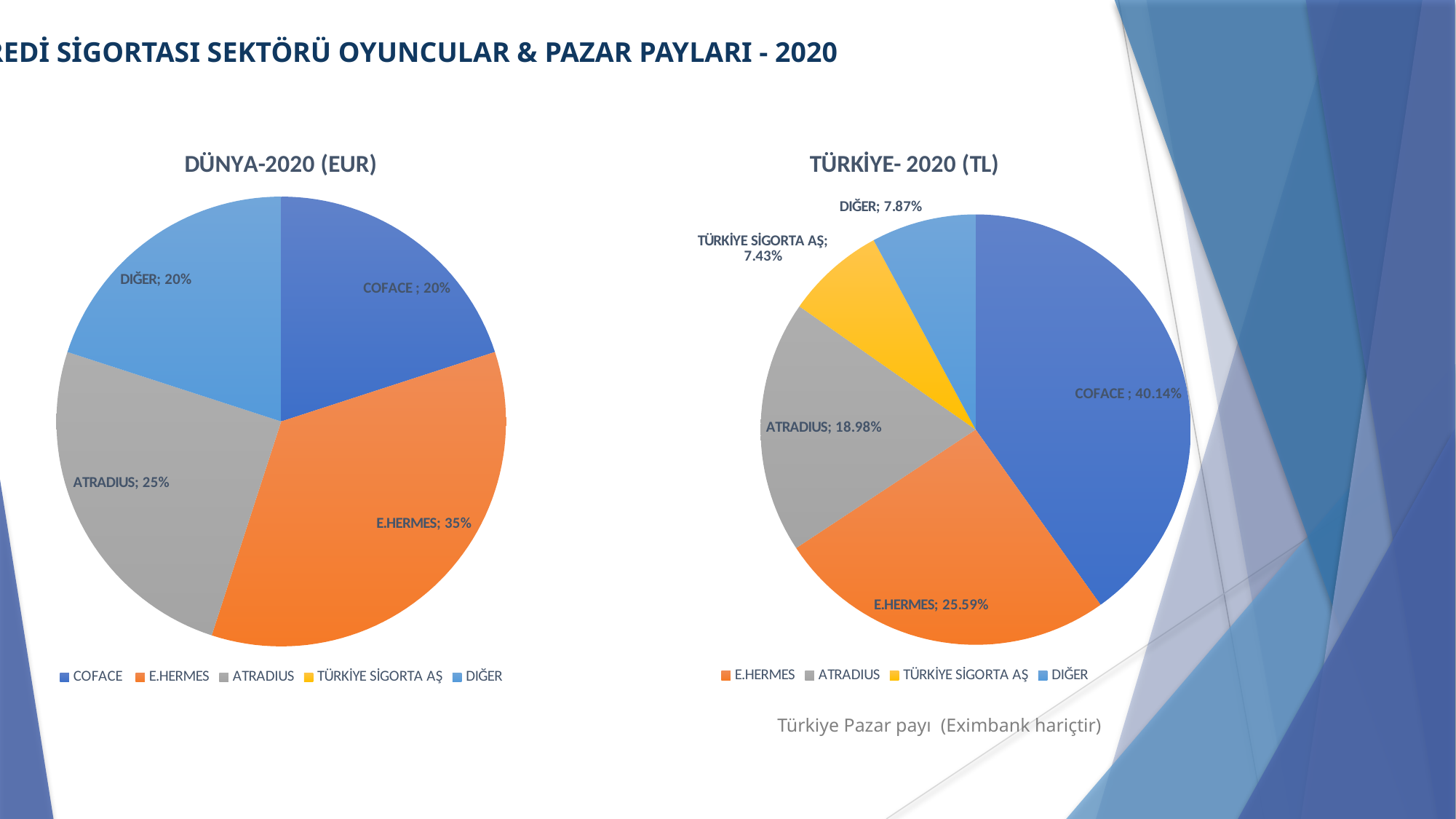
In the TÜRKİYE- 2020 (TL) chart, what share does COFACE hold? 40.14% In the TÜRKİYE- 2020 (TL) chart, what share does DİĞER hold? 7.87% In the DÜNYA-2020 (EUR) chart, what share does ATRADIUS hold? 25% How many slices are shown in the TÜRKİYE- 2020 (TL) chart? 5 In the TÜRKİYE- 2020 (TL) chart, what is the difference between the COFACE share and the E.HERMES share? 14.55% In the TÜRKİYE- 2020 (TL) chart, which is larger, the E.HERMES share or the ATRADIUS share? E.HERMES What type of chart is the DÜNYA-2020 (EUR) chart? Pie chart In the DÜNYA-2020 (EUR) chart, which company has the largest slice? E.HERMES In the TÜRKİYE- 2020 (TL) chart, what share does TÜRKİYE SİGORTA AŞ hold? 7.43% In the DÜNYA-2020 (EUR) chart, what is the difference between the E.HERMES share and the COFACE share? 15% In the DÜNYA-2020 (EUR) chart, what share does E.HERMES hold? 35% In the TÜRKİYE- 2020 (TL) chart, which company has the smallest slice? TÜRKİYE SİGORTA AŞ